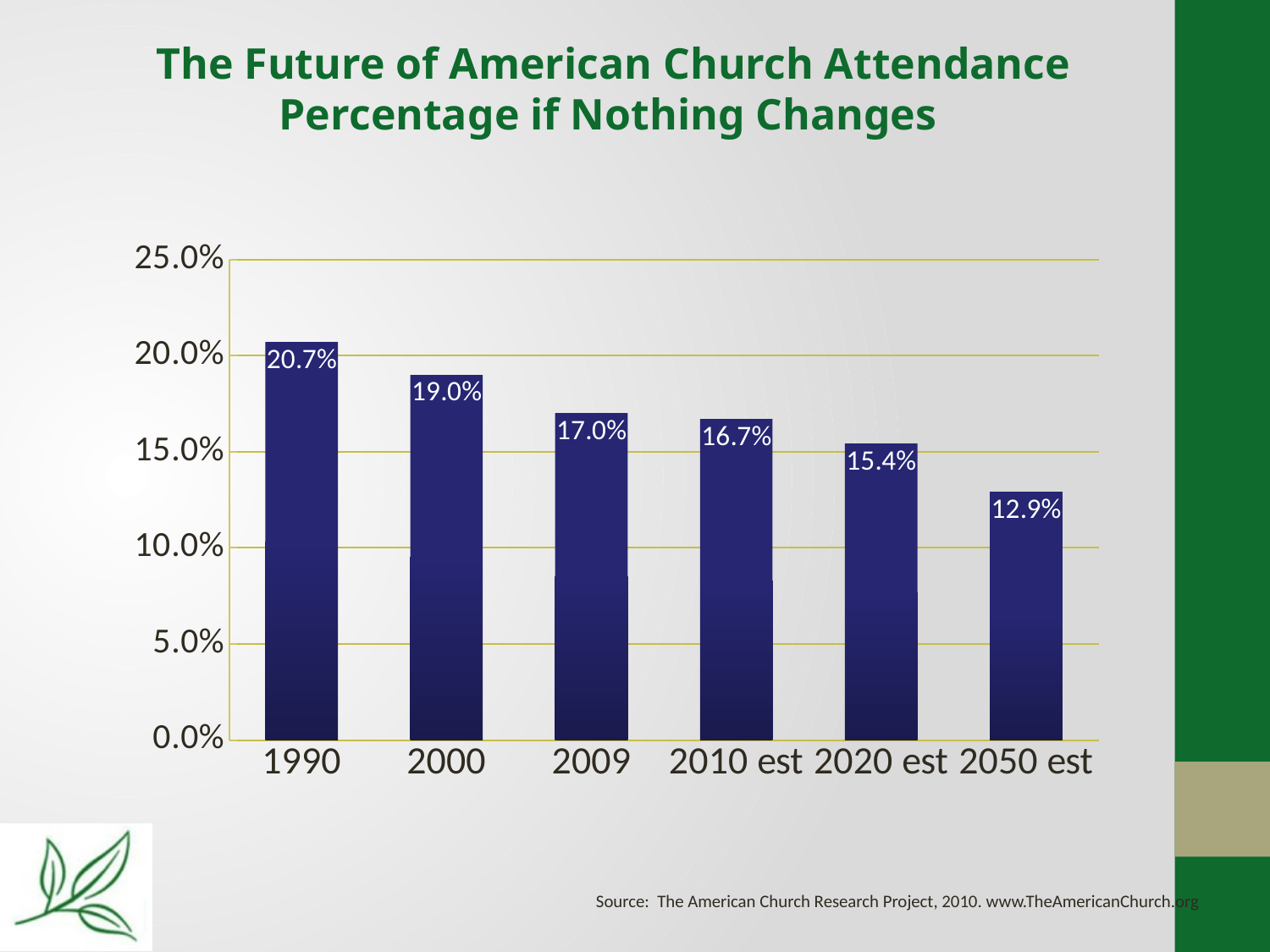
What kind of chart is shown on the slide? bar chart What is the church attendance percentage shown for 1990? 20.7% What is the difference between the values for 2000 and 2009? 2.0% How many categories are shown on the x axis? 6 Which category has the lowest attendance percentage? 2050 est What is the value shown for 2009? 17.0% Which is larger, the value for 2010 est or the value for 2020 est? 2010 est Which year has the highest attendance percentage? 1990 Is the value for 2020 est greater or less than 20.0%? less What is the value shown for 2050 est? 12.9% Do the values rise or fall from 1990 to 2050 est? fall What is the difference between the values for 1990 and 2050 est? 7.8%